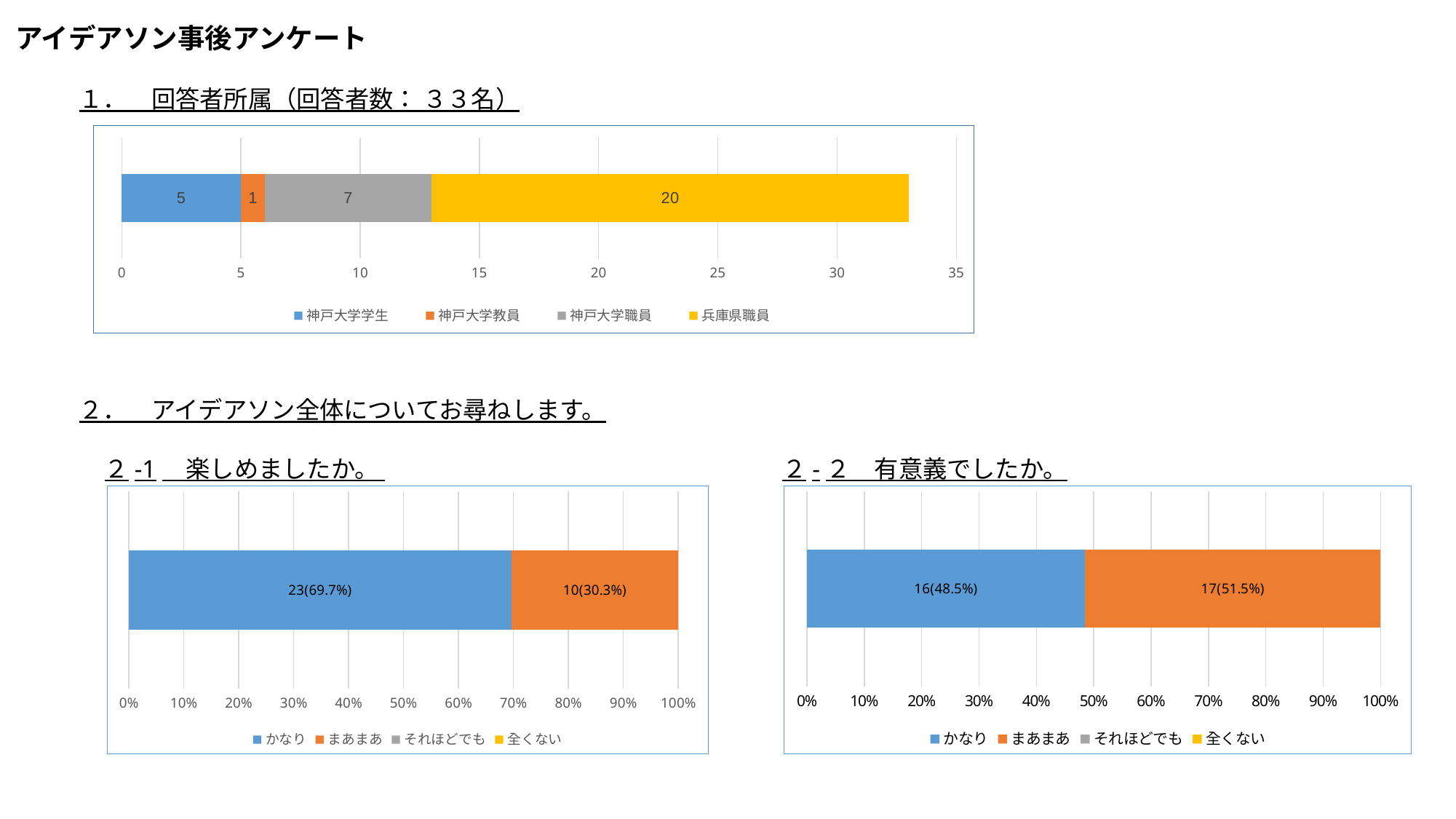
In the chart under "１．回答者所属", which series has the highest value? 兵庫県職員 In the chart under "２-1 楽しめましたか。", what is the data label for かなり? 23(69.7%) What kind of chart is shown under "２-２ 有意義でしたか。"? Stacked bar chart In the chart under "１．回答者所属", what is the difference between the values for 兵庫県職員 and 神戸大学学生? 15 In the chart under "２-２ 有意義でしたか。", what is the data label for まあまあ? 17(51.5%) In the chart under "１．回答者所属", what is the value for 兵庫県職員? 20 In the chart under "２-２ 有意義でしたか。", what is the difference between the counts for まあまあ and かなり? 1 In the chart under "１．回答者所属", which series has the lowest value? 神戸大学教員 In the chart under "１．回答者所属", how many series does the legend list? 4 In the chart under "１．回答者所属", what is the total of the stacked bar? 33 In the chart under "１．回答者所属", what is the value for 神戸大学職員? 7 In the chart under "２-1 楽しめましたか。", which is larger, かなり or まあまあ? かなり